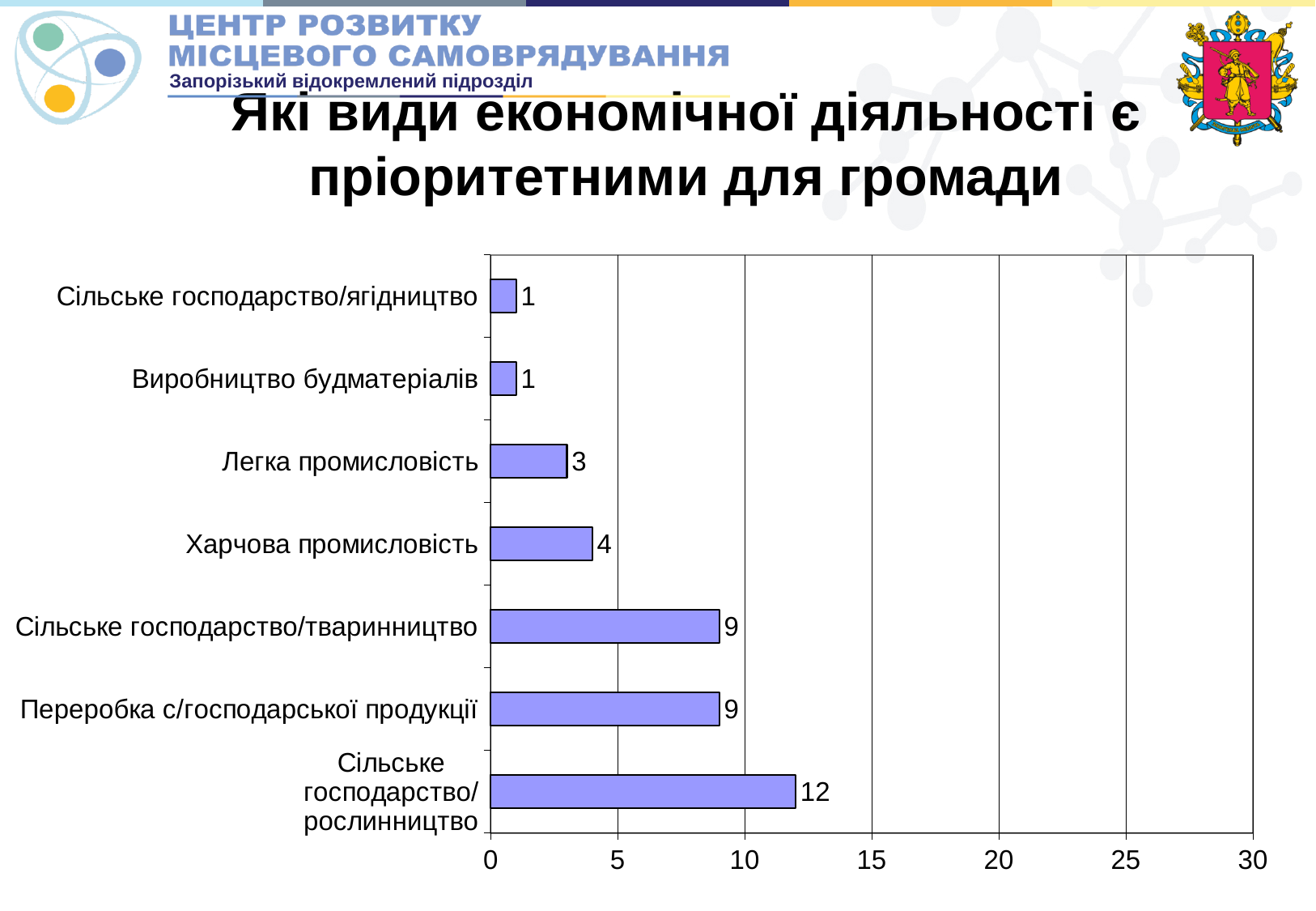
What is the value for Переробка с/господарської продукції? 9 What is the value for Харчова промисловість? 4 What kind of chart is shown on the slide? bar chart What is the value for Виробництво будматеріалів? 1 What is the value for Сільське господарство/рослинництво? 12 What is the maximum value shown on the horizontal axis? 30 Is the value for Сільське господарство/рослинництво greater or less than 10? greater How many categories are shown in the chart? 7 What is the difference between the values for Сільське господарство/рослинництво and Сільське господарство/тваринництво? 3 Which category has the highest value? Сільське господарство/рослинництво Which is larger: the value for Харчова промисловість or the value for Легка промисловість? Харчова промисловість What is the value for Легка промисловість? 3